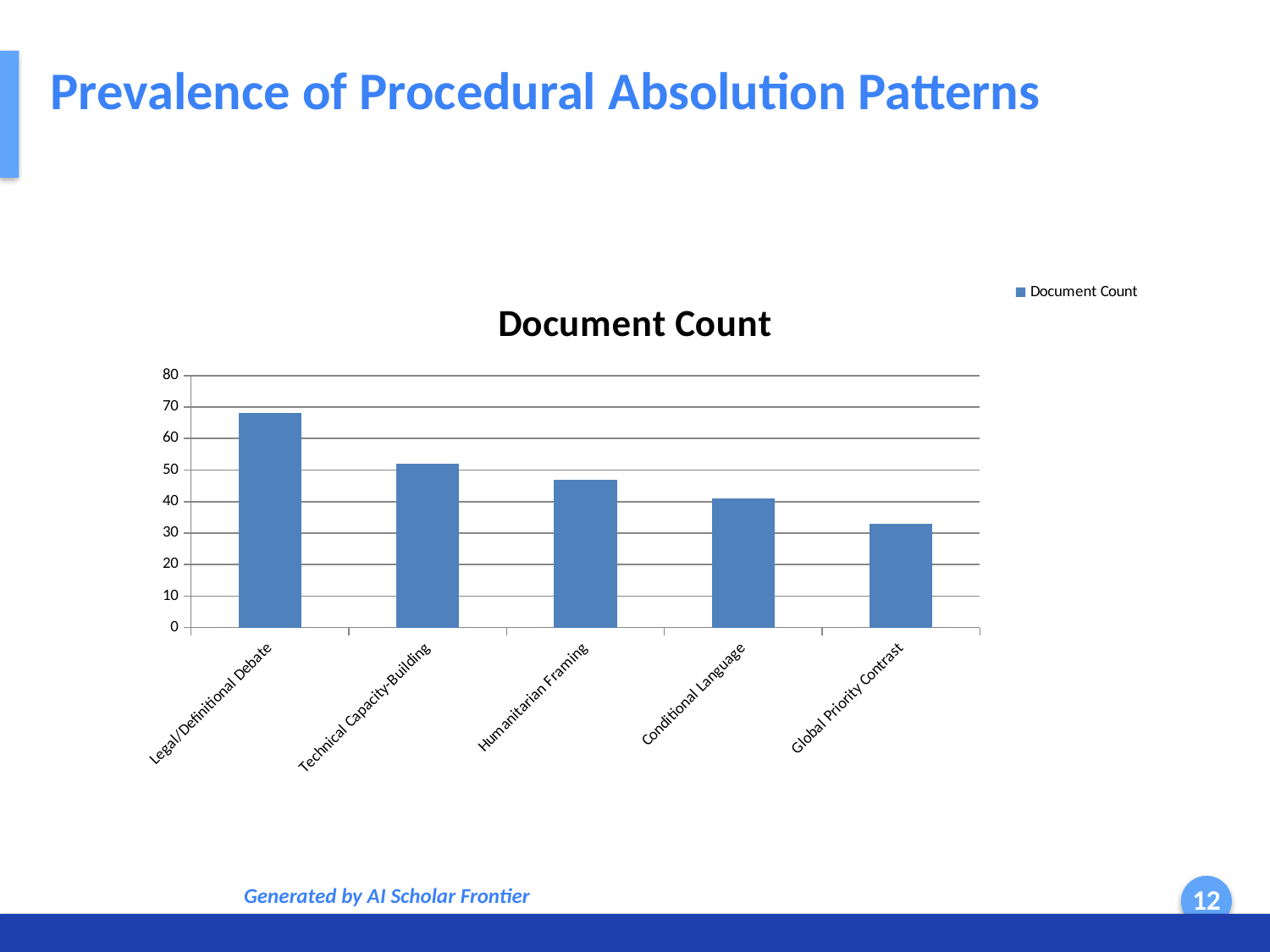
Which is larger, the value for Humanitarian Framing or the value for Conditional Language? Humanitarian Framing Is the value for Legal/Definitional Debate greater or less than 60? greater What is the title of the chart? Document Count Do the values rise or fall moving from left to right along the x axis? fall What kind of chart is shown on the slide? bar chart Is the value for Global Priority Contrast greater or less than 40? less How many categories are shown on the x axis of the chart? 5 Is the value for Conditional Language greater or less than 50? less Which category has the lowest document count? Global Priority Contrast How many series does the legend list? 1 Which category has the highest document count? Legal/Definitional Debate